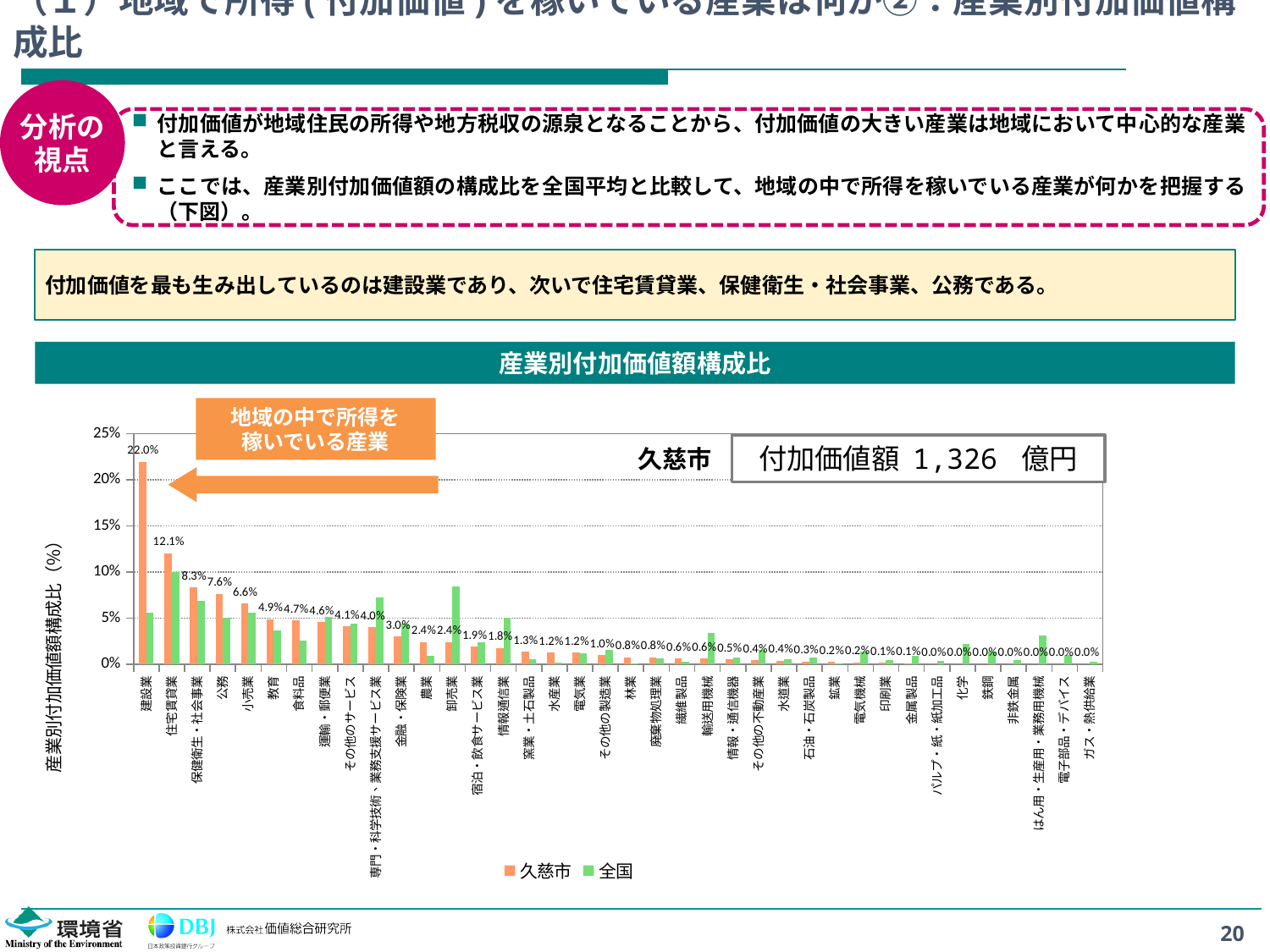
What is the value for 住宅賃貸業 in the 久慈市 series? 12.1% What is the difference between the 久慈市 values for 建設業 and 住宅賃貸業? 9.9% What is the value for 建設業 in the 久慈市 series? 22.0% What is the difference between the 久慈市 values for 保健衛生・社会事業 and 公務? 0.7% What is the value for 公務 in the 久慈市 series? 7.6% Which industry has the highest value in the 久慈市 series? 建設業 What is the title of the chart? 産業別付加価値額構成比 Is the 全国 value for 卸売業 greater or less than 5%? greater What is the value for 小売業 in the 久慈市 series? 6.6% For 卸売業, which series has the larger value, 久慈市 or 全国? 全国 What kind of chart is shown on the slide? bar chart How many series does the legend list? 2